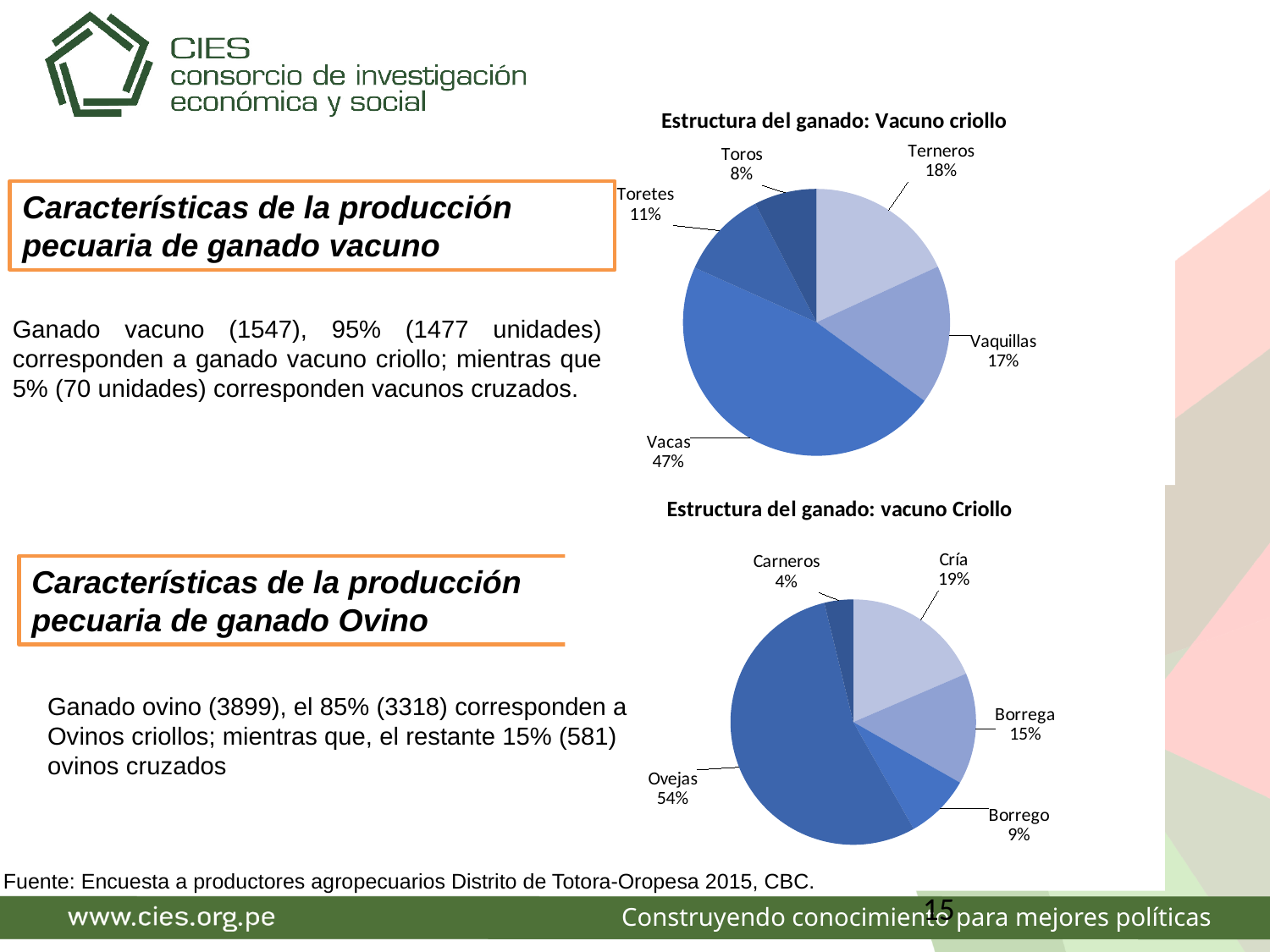
In the bottom pie chart, what share do Ovejas represent? 54% What type of chart is the bottom chart? Pie chart In the bottom pie chart, which is larger, Borrega or Borrego? Borrega How many slices does the top pie chart have? 5 In the top pie chart, what percentage is shown for Toretes? 11% In the top pie chart, what is the difference between the shares of Terneros and Toros? 10% In the bottom pie chart, what percentage is shown for Carneros? 4% What is the title of the top chart? Estructura del ganado: Vacuno criollo In the bottom pie chart, what is the difference between the shares of Cría and Borrego? 10% In the top pie chart, which category has the smallest share? Toros In the top pie chart, what share do Vacas represent? 47% In the top pie chart, which category has the largest share? Vacas